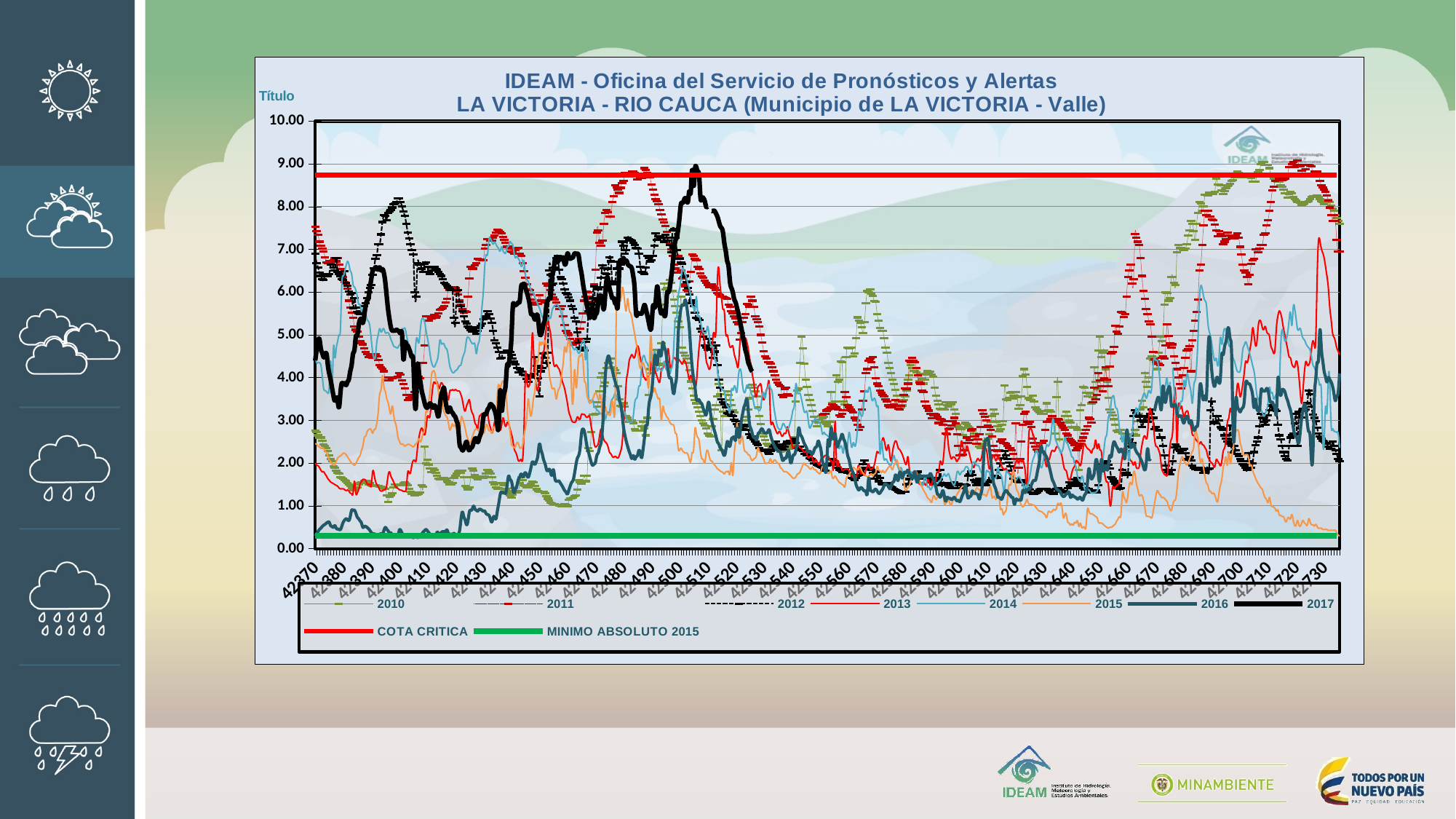
Is the value of the 2015 series at 42730 greater or less than 1.00? less Is the MINIMO ABSOLUTO 2015 line greater or less than 1.00 on the vertical axis? less Is the COTA CRITICA line greater or less than 8.00 on the vertical axis? greater Which is larger at 42510: the 2017 series or the 2015 series? 2017 What is the highest value shown on the chart's vertical axis? 10.00 What kind of chart is shown on the slide? line chart How many entries does the chart's legend list? 10 What is the first label on the chart's horizontal axis? 42370 Which is larger at 42730: the 2010 series or the 2015 series? 2010